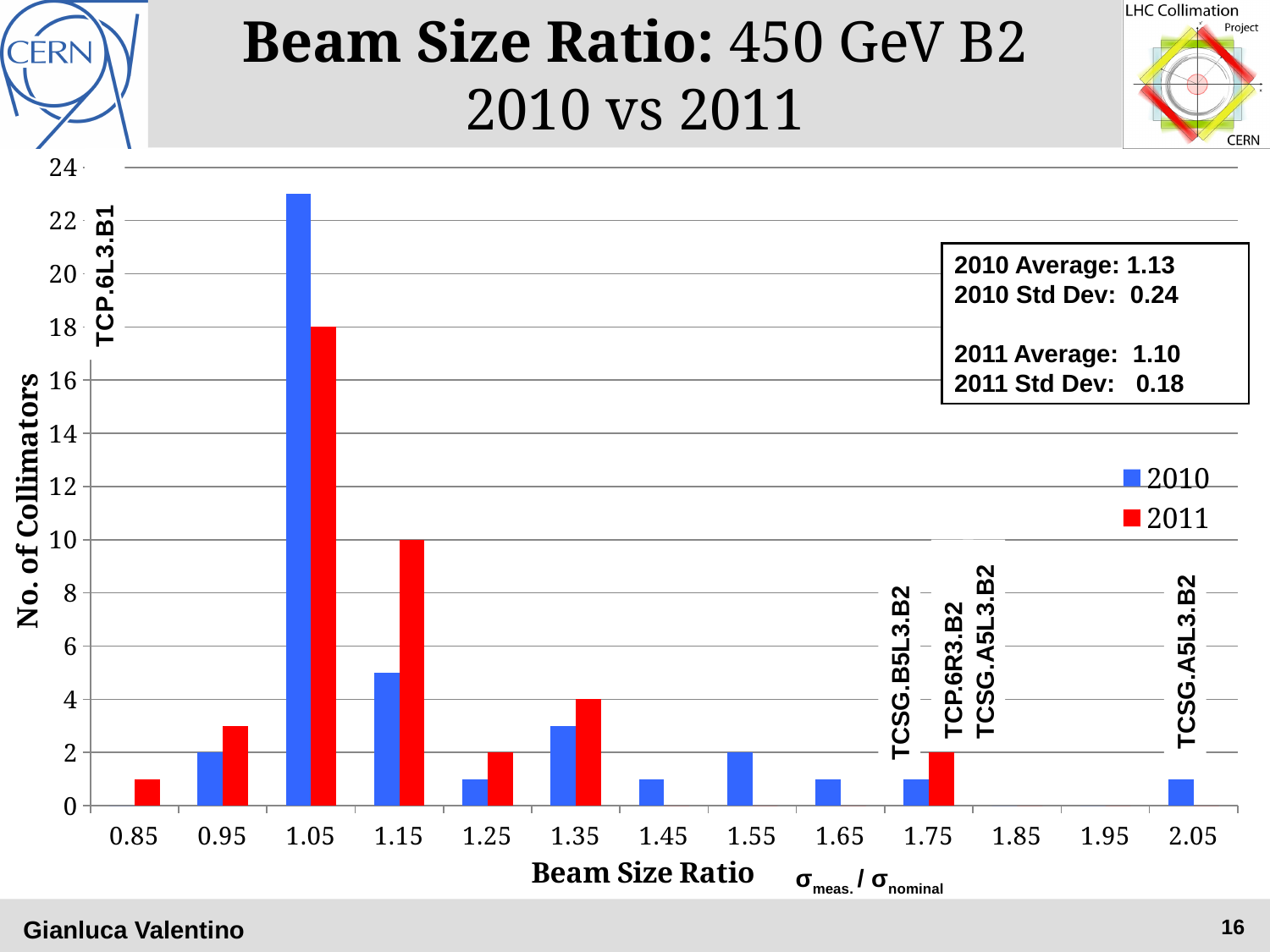
What is the number of collimators for 2011 at a beam size ratio of 1.15? 10 According to the text box on the chart, what is the 2010 average beam size ratio? 1.13 At which beam size ratio does the 2010 series reach its highest value? 1.05 Which two series are listed in the legend? 2010 and 2011 What is the number of collimators for 2011 at a beam size ratio of 1.35? 4 How many series does the legend list? 2 What kind of chart is shown on the slide? bar chart What is the number of collimators for 2010 at a beam size ratio of 0.95? 2 What is the number of collimators for 2011 at a beam size ratio of 1.05? 18 Is the 2010 value at a beam size ratio of 1.05 greater or less than 22? greater How many beam size ratio categories are shown on the x axis? 13 At a beam size ratio of 1.15, which series has the larger value, 2010 or 2011? 2011